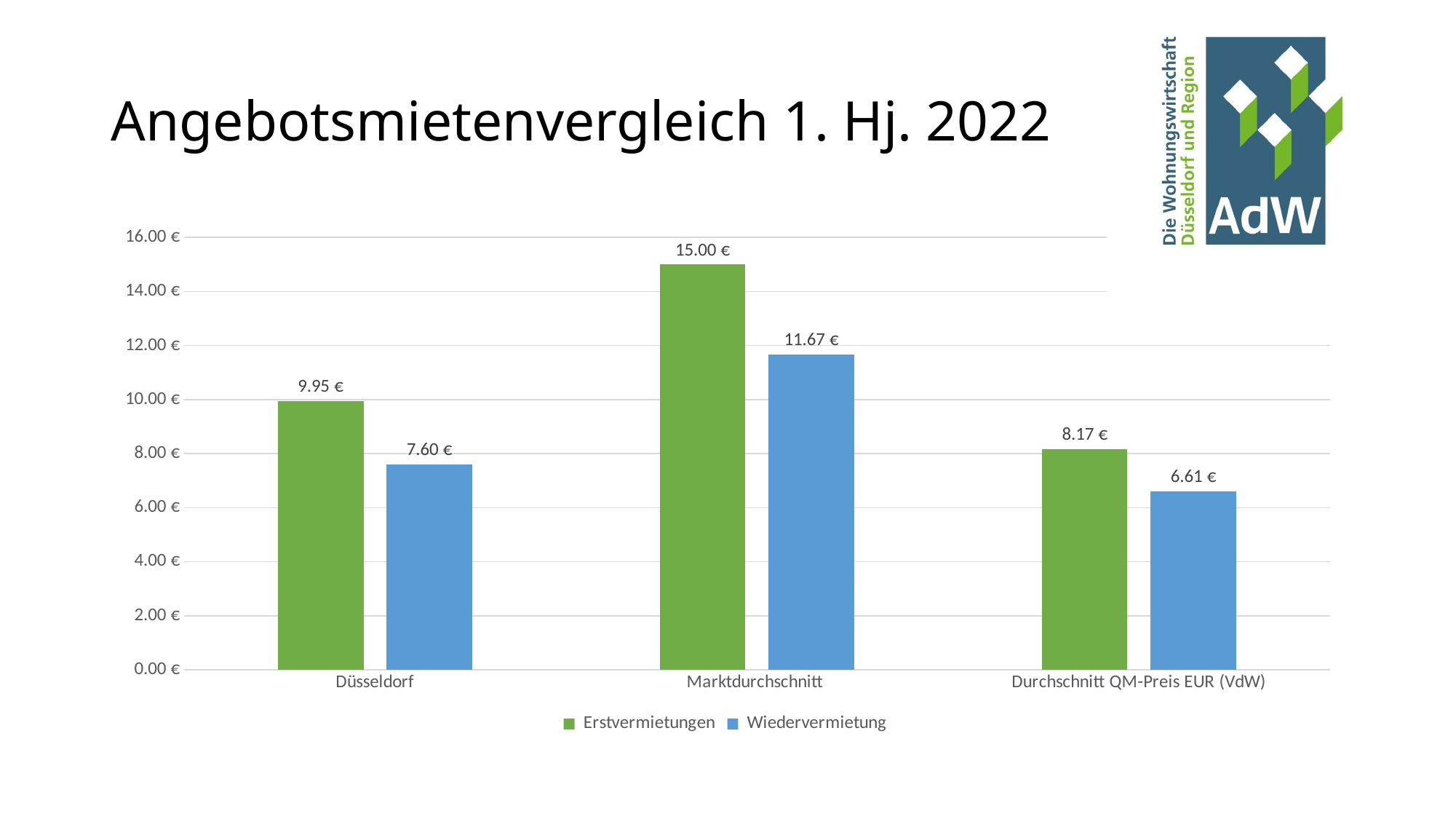
What kind of chart is shown on the slide? bar chart Which is larger: the Erstvermietungen value for Düsseldorf or the Erstvermietungen value for Durchschnitt QM-Preis EUR (VdW)? Düsseldorf What is the Erstvermietungen value for Düsseldorf? 9.95 € Is the Wiedervermietung value for Düsseldorf greater or less than 8.00 €? less What is the Wiedervermietung value for Durchschnitt QM-Preis EUR (VdW)? 6.61 € Which category has the lowest Wiedervermietung value? Durchschnitt QM-Preis EUR (VdW) How many categories are shown on the x axis? 3 How many series does the legend list? 2 What is the Wiedervermietung value for Marktdurchschnitt? 11.67 € What is the difference between the Erstvermietungen and Wiedervermietung values for Marktdurchschnitt? 3.33 € Which category has the highest Erstvermietungen value? Marktdurchschnitt What is the title of the slide? Angebotsmietenvergleich 1. Hj. 2022